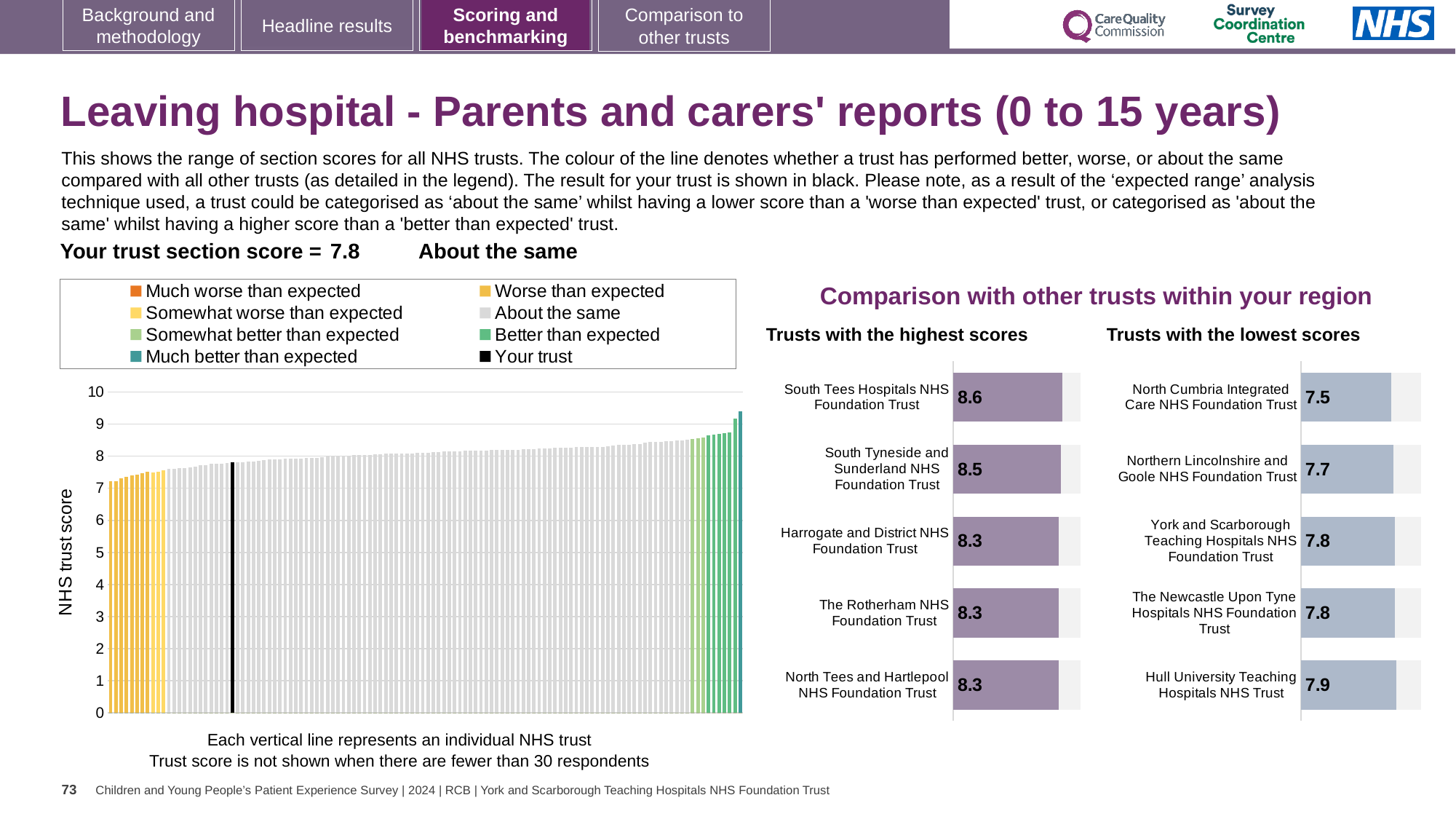
In the 'Trusts with the lowest scores' chart, what is the score for North Cumbria Integrated Care NHS Foundation Trust? 7.5 In the 'Trusts with the lowest scores' chart, what is the score for Hull University Teaching Hospitals NHS Trust? 7.9 In the 'Trusts with the highest scores' chart, which trust has the highest score? South Tees Hospitals NHS Foundation Trust In the large chart on the left, do the trust scores rise or fall from left to right? Rise Which has the higher score: South Tees Hospitals NHS Foundation Trust in the highest scores chart or North Cumbria Integrated Care NHS Foundation Trust in the lowest scores chart? South Tees Hospitals NHS Foundation Trust In the 'Trusts with the lowest scores' chart, which trust has the lowest score? North Cumbria Integrated Care NHS Foundation Trust In the 'Trusts with the lowest scores' chart, what is the difference between the scores of Hull University Teaching Hospitals NHS Trust and North Cumbria Integrated Care NHS Foundation Trust? 0.4 How many trusts are shown in the 'Trusts with the lowest scores' chart? 5 What kind of chart is the large chart on the left showing NHS trust scores? Bar chart In the 'Trusts with the highest scores' chart, what is the score for South Tyneside and Sunderland NHS Foundation Trust? 8.5 In the 'Trusts with the highest scores' chart, what is the score for South Tees Hospitals NHS Foundation Trust? 8.6 In the 'Trusts with the highest scores' chart, what is the difference between the scores of South Tees Hospitals NHS Foundation Trust and Harrogate and District NHS Foundation Trust? 0.3